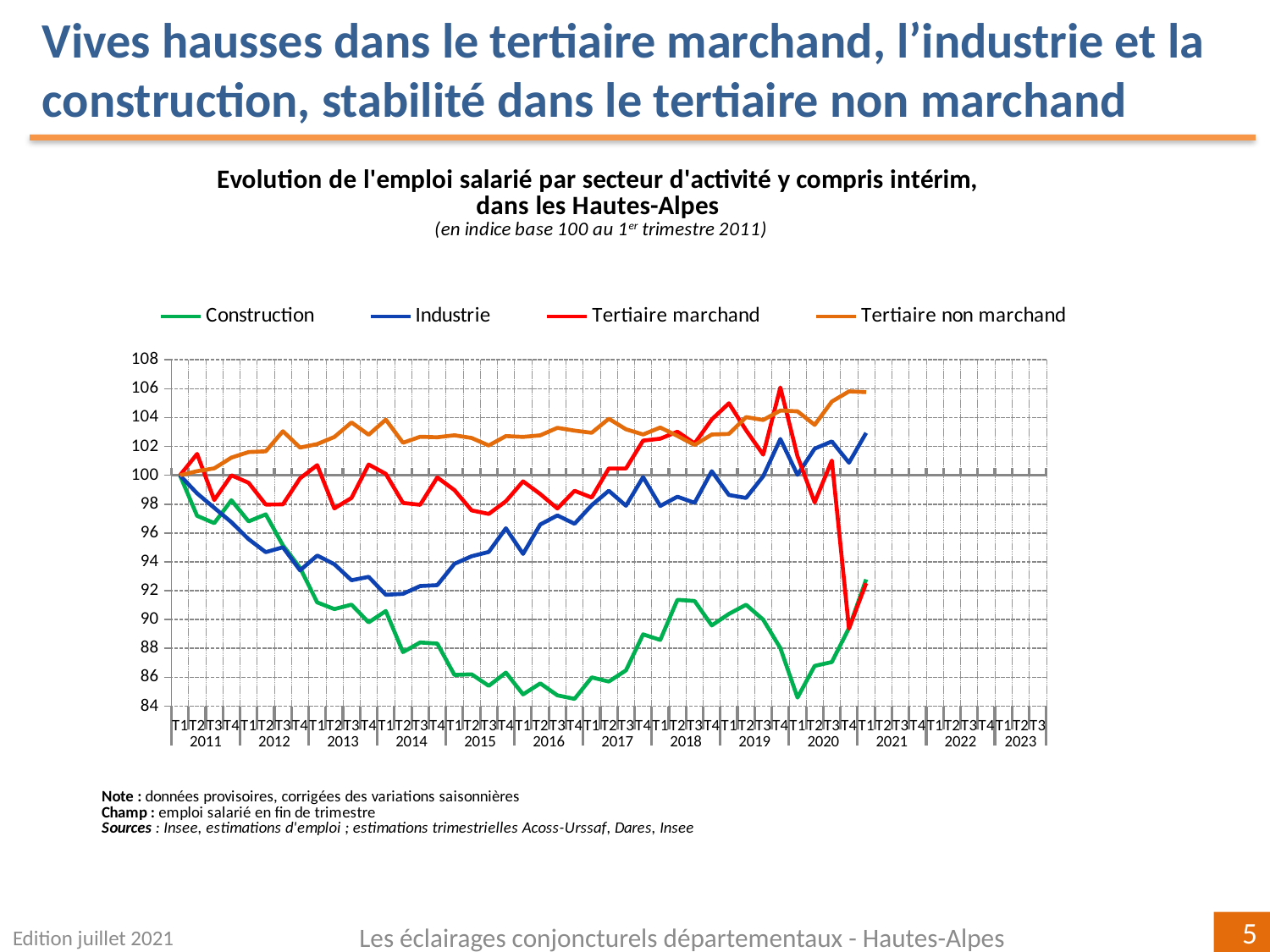
What kind of chart is shown on the slide? line chart Does the Construction series rise or fall between 2011 and 2016? fall Which series is drawn in green? Construction Is the value for Tertiaire marchand at T4 2020 greater or less than 92? less Which series has the lowest value at T1 2020? Construction Is the value for Construction at T1 2020 greater or less than 90? less How many years are labelled on the x axis? 13 At T1 2021, which is larger: Industrie or Construction? Industrie Is the value for Tertiaire non marchand at T1 2021 greater or less than 104? greater Which series has the highest value at T1 2021? Tertiaire non marchand How many series does the legend list? 4 What is the index value of all four series at T1 2011? 100